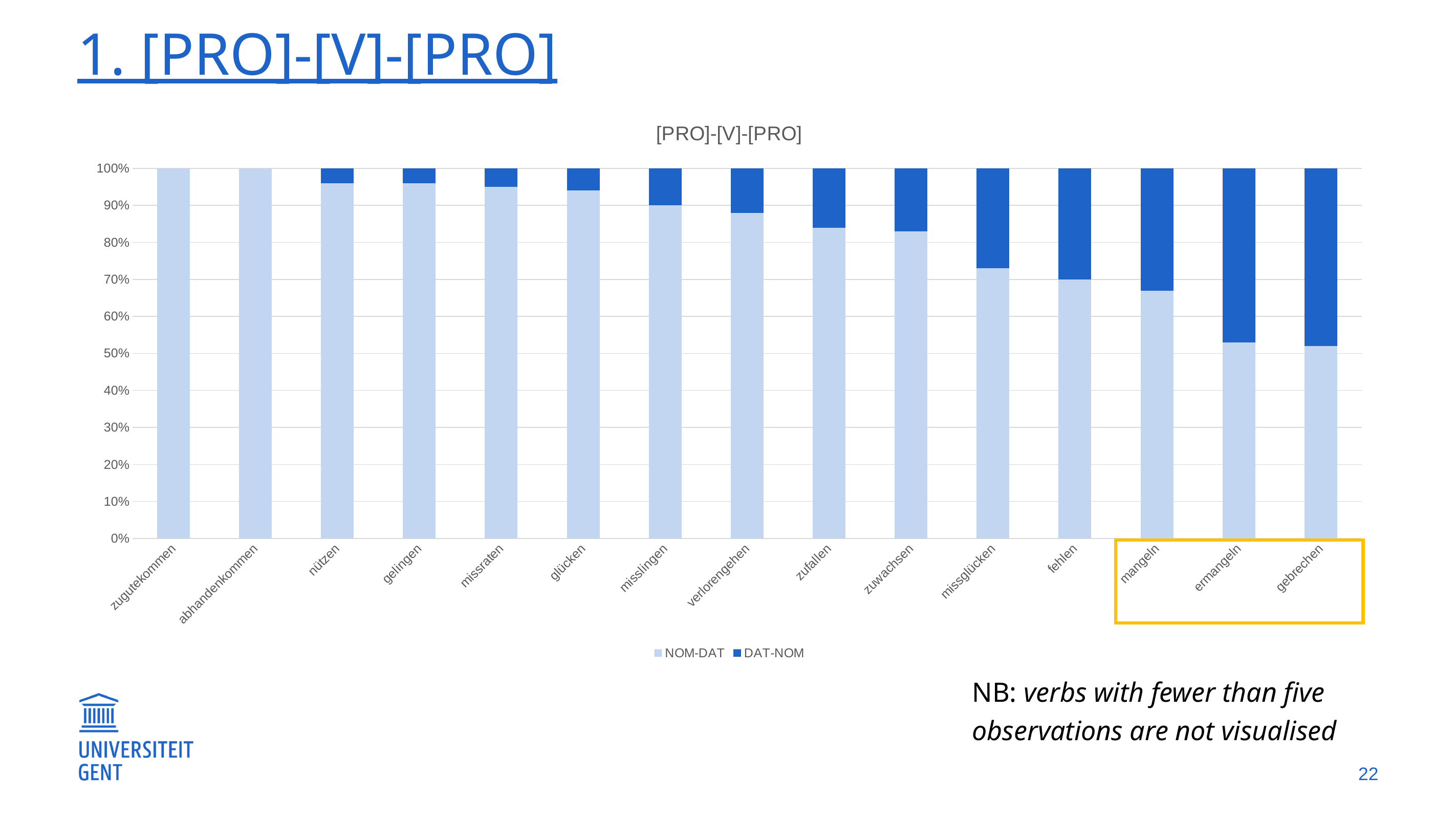
What is the title of the chart? [PRO]-[V]-[PRO] What is the NOM-DAT share for zugutekommen? 100% Does the NOM-DAT share rise or fall moving from left to right along the x axis? fall Is the NOM-DAT share for missglücken greater or less than 80%? less Which verb has the larger DAT-NOM share, gebrechen or nützen? gebrechen What is the NOM-DAT share for abhandenkommen? 100% Is the NOM-DAT share for gebrechen greater or less than 60%? less How many series does the legend list? 2 How many verbs (categories) are plotted on the x axis? 15 Is the NOM-DAT share for nützen greater or less than 90%? greater What kind of chart is shown on the slide? bar chart What are the two series named in the legend? NOM-DAT and DAT-NOM